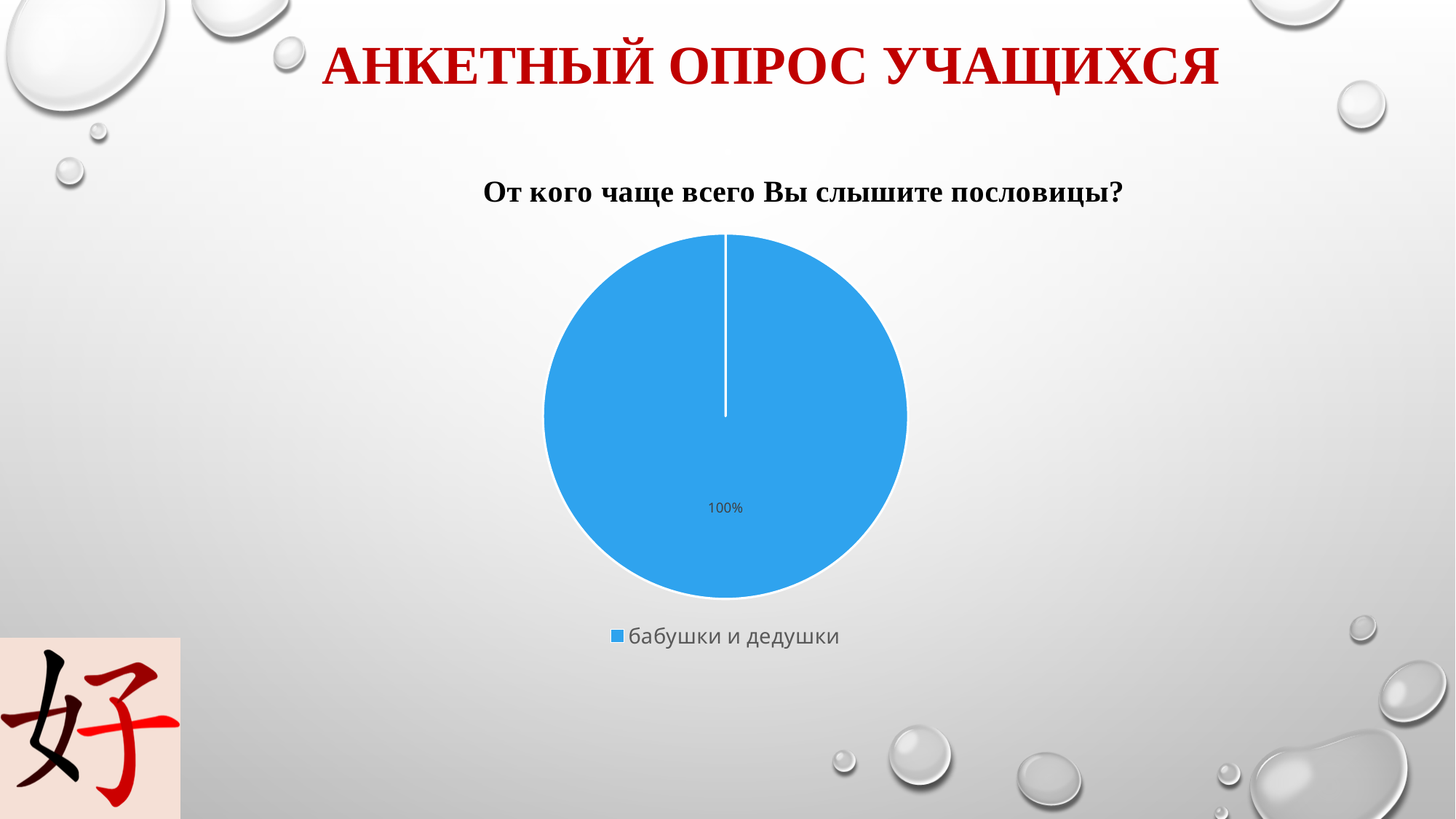
How many categories does the legend of the pie chart list? 1 What is the data label printed on the pie slice? 100% Is the value for "бабушки и дедушки" greater or less than 50%? greater Which category is listed in the legend of the pie chart? бабушки и дедушки What kind of chart is shown on the slide? pie chart What is the title of the chart? От кого чаще всего Вы слышите пословицы? What share of the pie does the slice for "бабушки и дедушки" represent? 100% How many slices does the pie chart have? 1